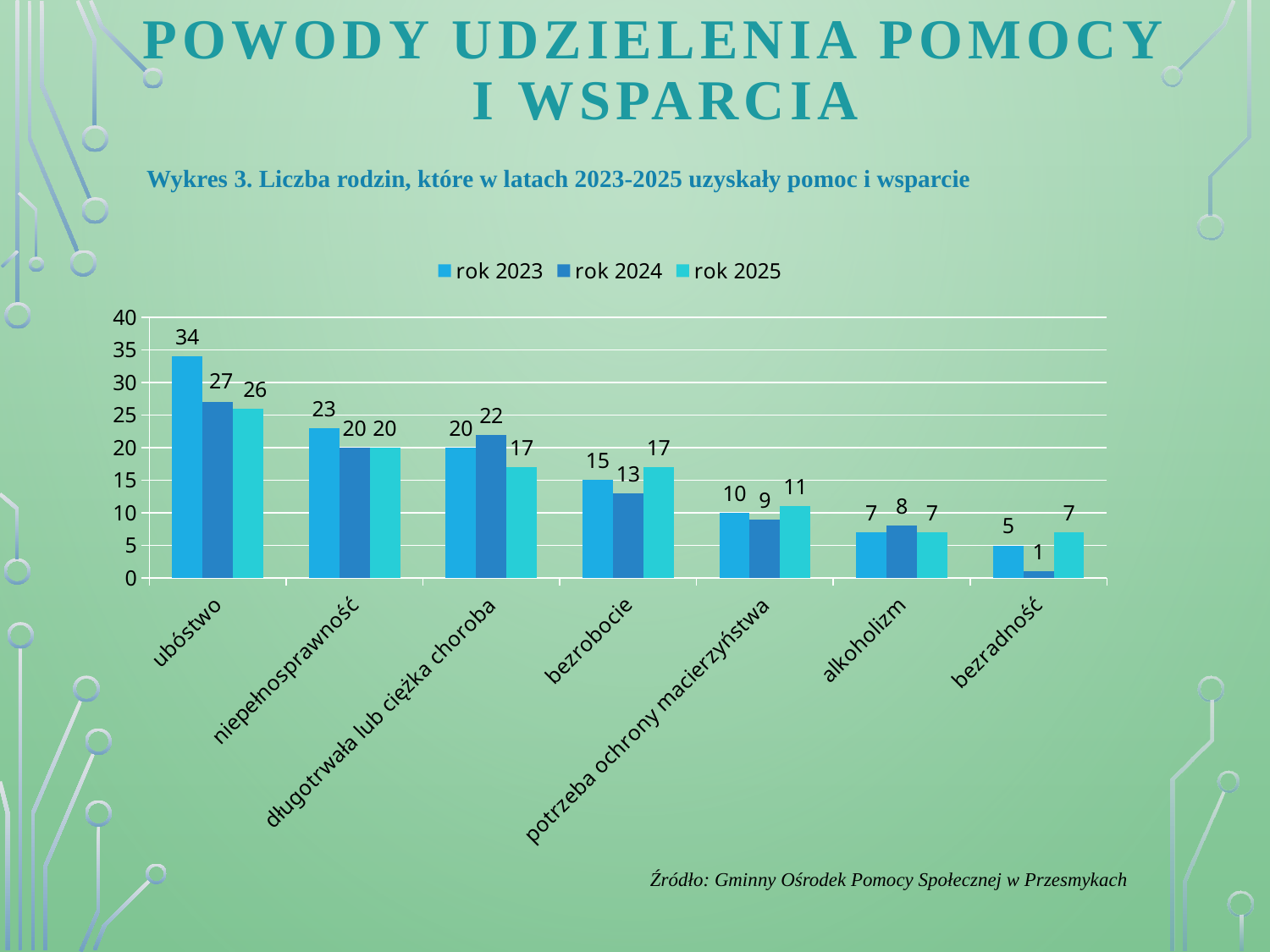
Which category has the highest value in rok 2023? ubóstwo Which is larger for bezrobocie: the rok 2024 value or the rok 2025 value? rok 2025 What is the value for ubóstwo in rok 2023? 34 What is the value for potrzeba ochrony macierzyństwa in rok 2025? 11 How many series does the legend list? 3 Which category has the lowest value in rok 2024? bezradność What is the title of the chart as given on the slide? Wykres 3. Liczba rodzin, które w latach 2023-2025 uzyskały pomoc i wsparcie What is the difference between the rok 2023 and rok 2025 values for ubóstwo? 8 Do the rok 2023 values rise or fall from ubóstwo to bezradność along the x axis? fall How many categories are shown on the x axis? 7 What is the value for bezradność in rok 2024? 1 What kind of chart is shown on the slide? bar chart